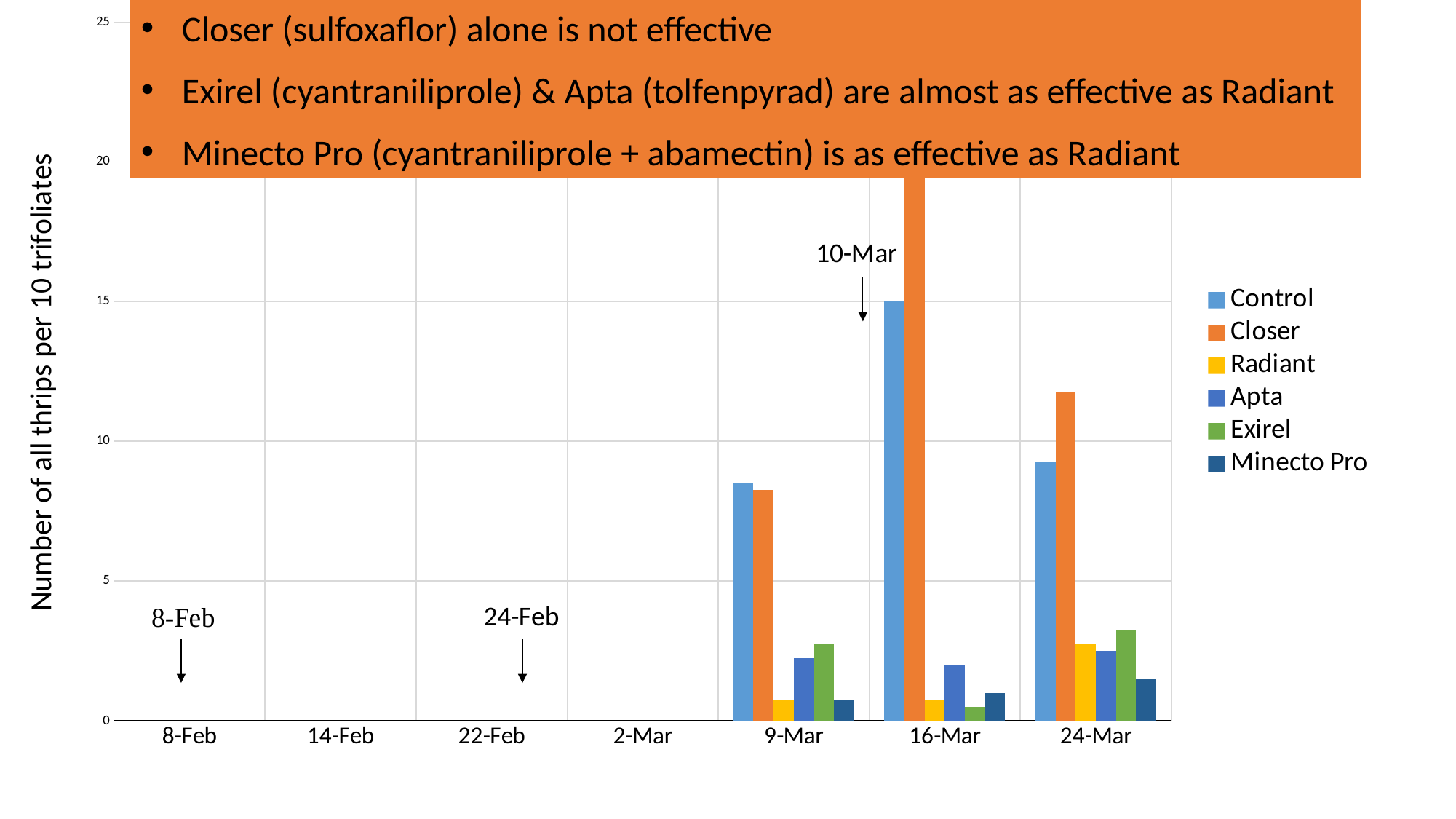
On 24-Mar, which is larger, Closer or Control? Closer Which series has the lowest value on 24-Mar? Minecto Pro How many series does the legend list? 6 How many date categories are shown on the x axis? 7 Is the value for Radiant on 9-Mar greater or less than 5? less Which series has the highest value on 24-Mar? Closer On 16-Mar, which is larger, Closer or Apta? Closer Is the value for Control on 16-Mar greater or less than 10? greater What is the title of the y axis? Number of all thrips per 10 trifoliates Is the value for Control on 9-Mar greater or less than 10? less What kind of chart is shown on the slide? bar chart